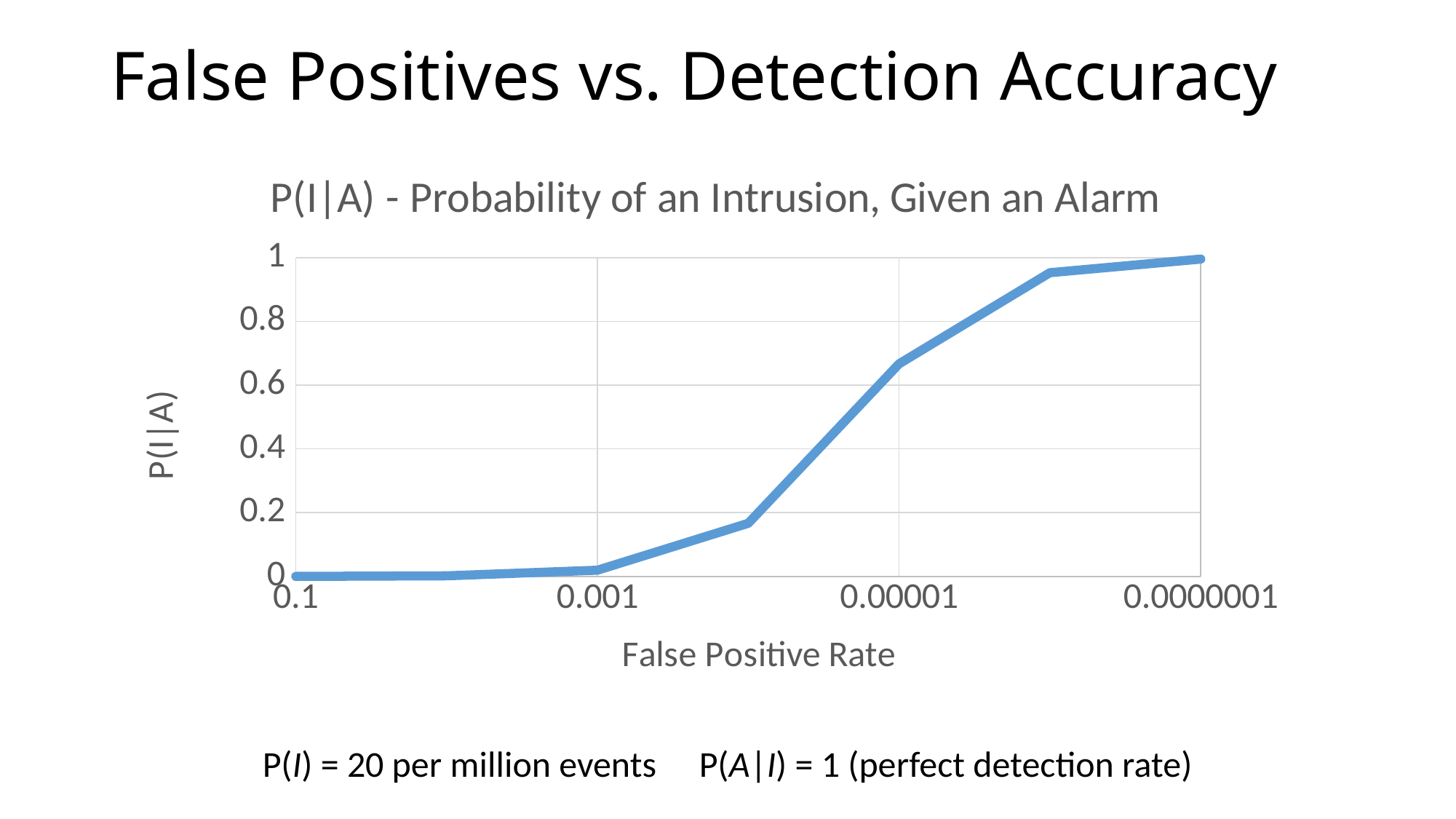
Is the value of P(I|A) at a false positive rate of 0.00001 greater or less than 0.6? greater Is the value of P(I|A) at a false positive rate of 0.0000001 greater or less than 0.8? greater Do the values of P(I|A) rise or fall moving from left to right along the x axis? rise Is the value of P(I|A) at a false positive rate of 0.1 greater or less than 0.2? less What is the title of the chart? P(I|A) - Probability of an Intrusion, Given an Alarm What kind of chart is shown on the slide? line chart Which false positive rate shown on the x axis has the highest P(I|A)? 0.0000001 What is the label of the x axis? False Positive Rate Which has a larger P(I|A): a false positive rate of 0.001 or 0.00001? 0.00001 What is the highest value shown on the y axis? 1